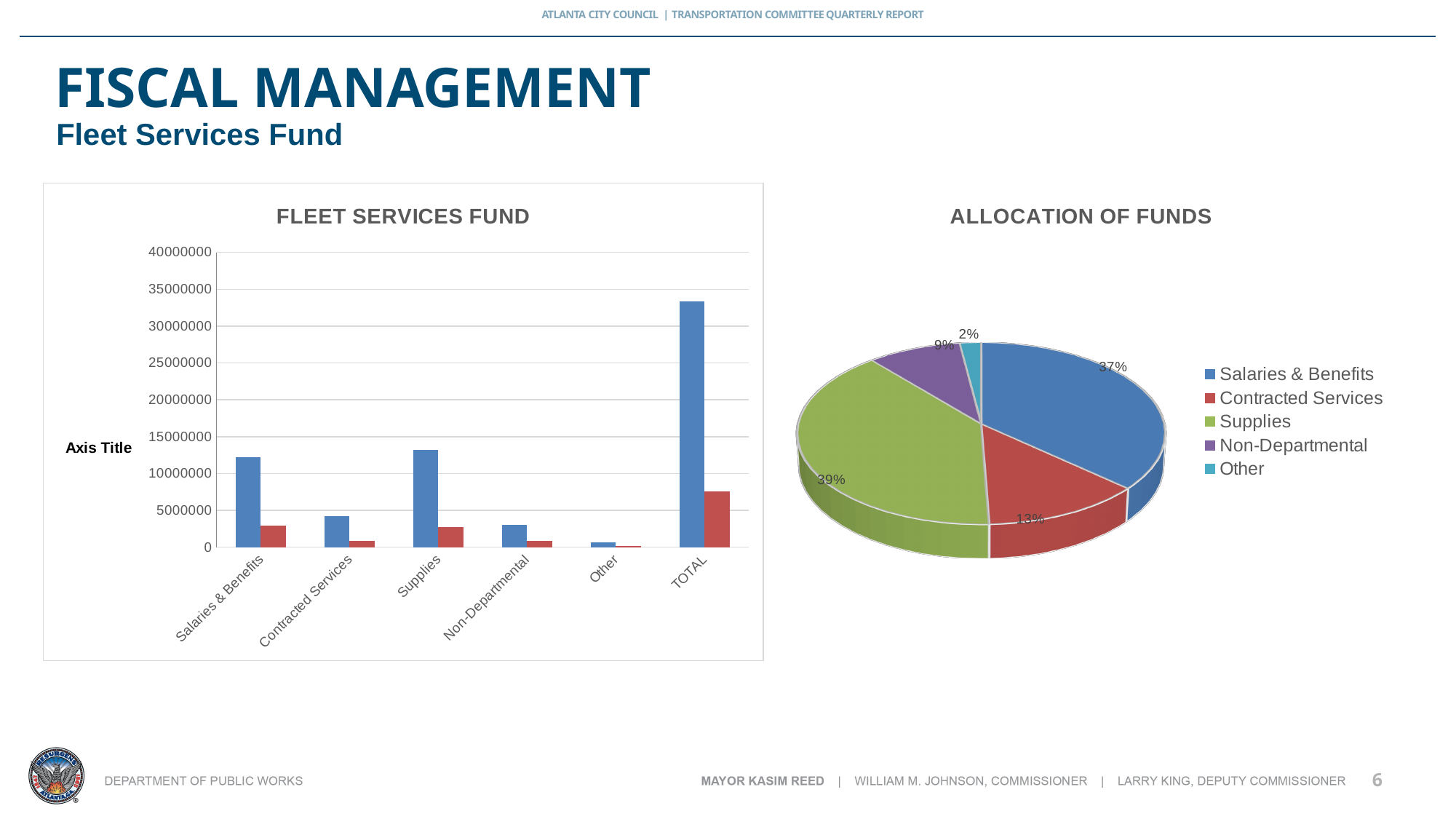
In the ALLOCATION OF FUNDS pie chart, which category has the smallest share? Other In the FLEET SERVICES FUND bar chart, which category has the tallest blue bar? TOTAL In the FLEET SERVICES FUND bar chart, how many categories are shown on the x axis? 6 In the FLEET SERVICES FUND bar chart, is the blue bar for Supplies greater or less than 10000000? greater In the ALLOCATION OF FUNDS pie chart, what share of funds goes to Supplies? 39% In the FLEET SERVICES FUND bar chart, is the blue bar for Contracted Services greater or less than 5000000? less In the FLEET SERVICES FUND bar chart, is the blue bar for TOTAL greater or less than 30000000? greater In the ALLOCATION OF FUNDS pie chart, what share of funds goes to Contracted Services? 13% How many entries does the legend of the ALLOCATION OF FUNDS pie chart list? 5 What type of chart is the FLEET SERVICES FUND chart on the left? bar chart In the FLEET SERVICES FUND bar chart, is the blue bar for Salaries & Benefits larger or smaller than the blue bar for Other? larger What type of chart is the ALLOCATION OF FUNDS chart on the right? pie chart